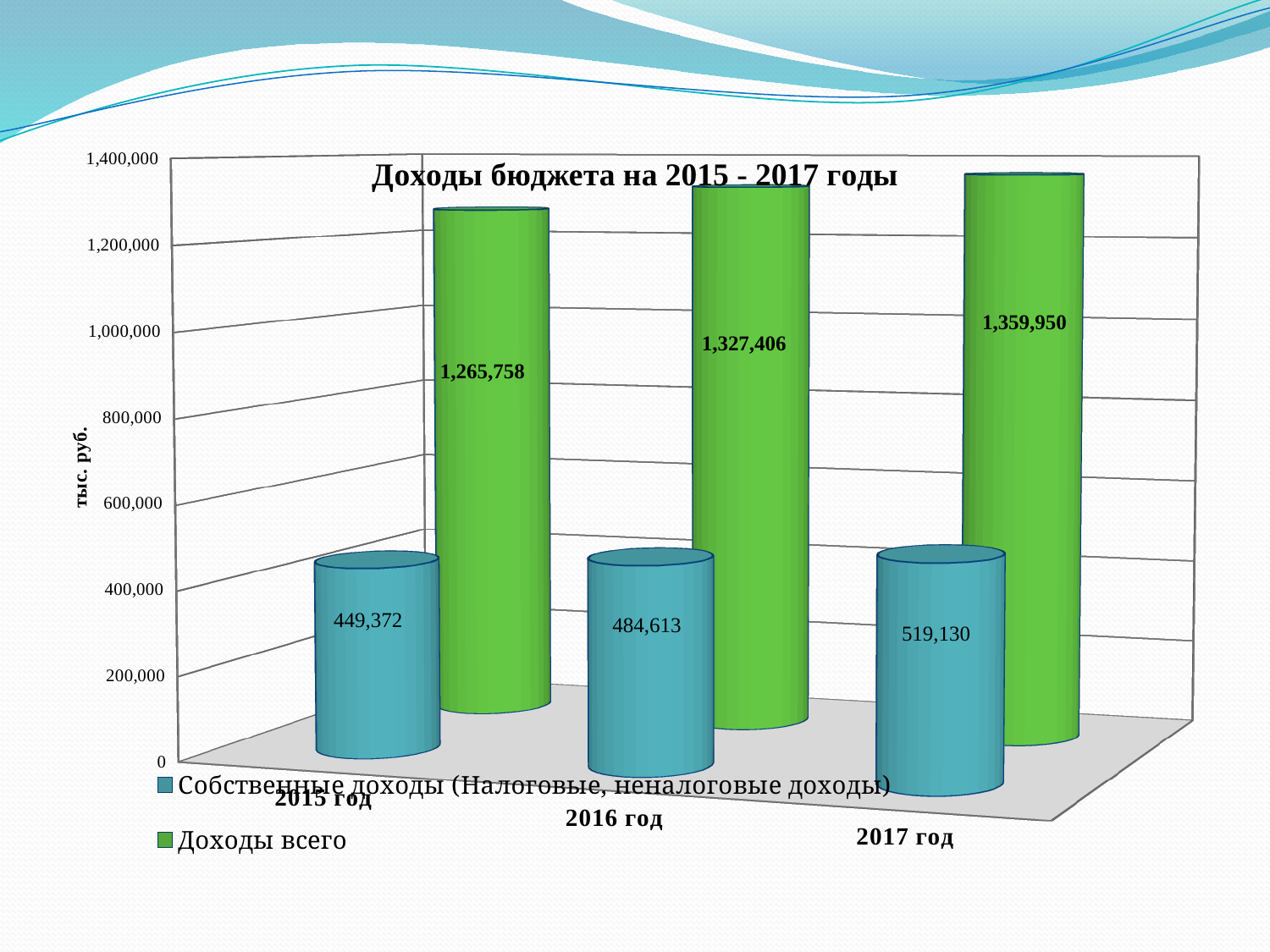
What is the difference between Собственные доходы in 2017 год and in 2015 год? 69,758 Do the values for Доходы всего rise or fall from 2015 год to 2017 год? Rise What is the value of Собственные доходы (Налоговые, неналоговые доходы) for 2017 год? 519,130 What is the value of Собственные доходы (Налоговые, неналоговые доходы) for 2015 год? 449,372 What is the difference between Доходы всего in 2017 год and in 2015 год? 94,192 How many series does the legend list? 2 What kind of chart is shown on the slide? Bar chart How many years are shown on the x axis? 3 Which year has the highest value for Доходы всего? 2017 год Which year has the lowest value for Собственные доходы (Налоговые, неналоговые доходы)? 2015 год Which is larger: Собственные доходы in 2016 год or Собственные доходы in 2017 год? Собственные доходы in 2017 год What is the value of Доходы всего for 2016 год? 1,327,406